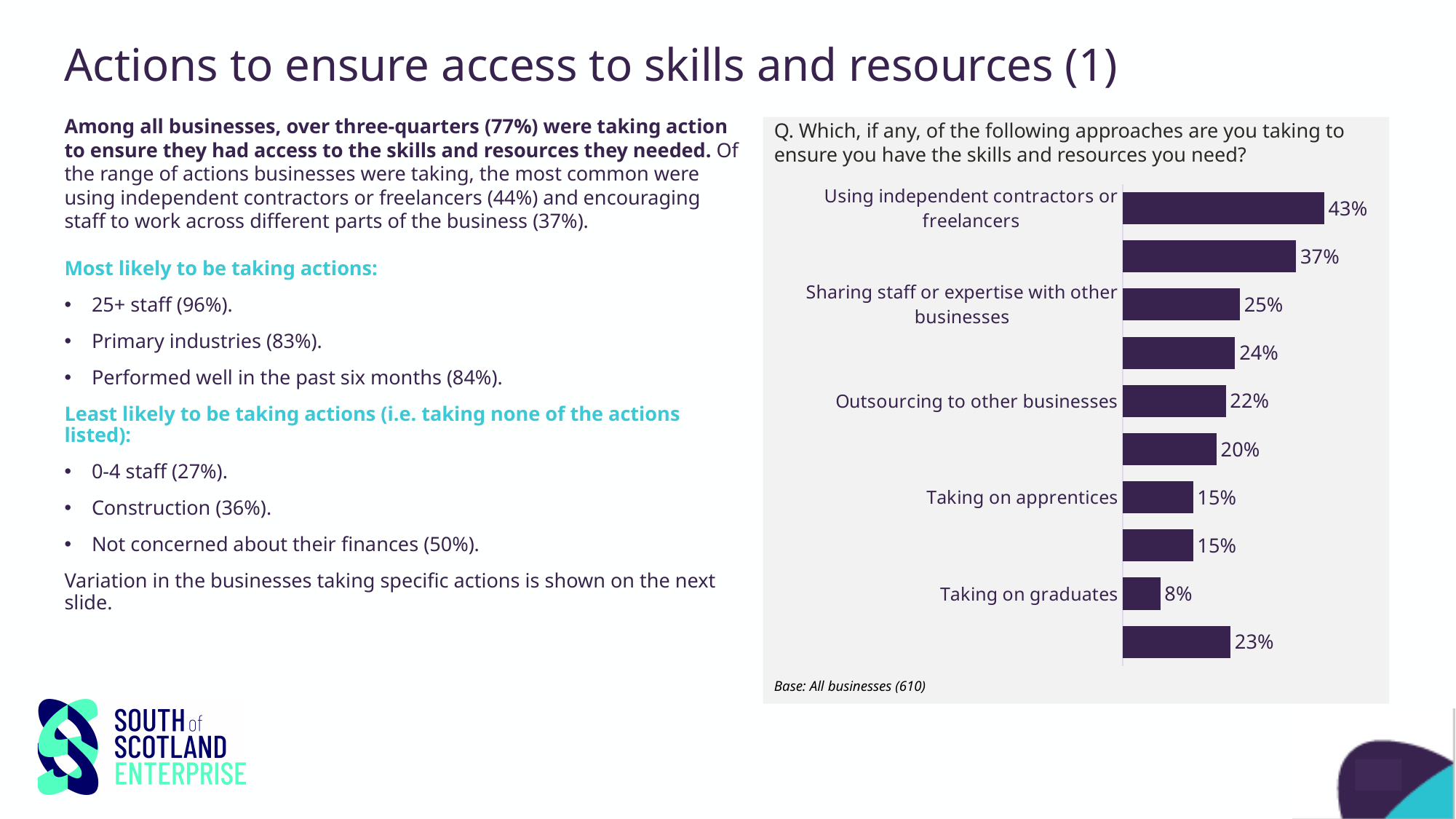
How many bars are plotted in the chart? 10 Which approach has the highest value in the chart? Using independent contractors or freelancers What is the difference in percentage points between 'Using independent contractors or freelancers' and 'Sharing staff or expertise with other businesses'? 18 percentage points What percentage of businesses are using independent contractors or freelancers? 43% What percentage of businesses are outsourcing to other businesses? 22% What is the base (number of respondents) stated beneath the chart? All businesses (610) What percentage of businesses are taking on graduates? 8% What type of chart is shown on the slide? Bar chart Which is larger: the value for 'Sharing staff or expertise with other businesses' or for 'Outsourcing to other businesses'? Sharing staff or expertise with other businesses Which labelled approach has the lowest value in the chart? Taking on graduates What is the value for 'Taking on apprentices'? 15% What is the value for 'Sharing staff or expertise with other businesses'? 25%